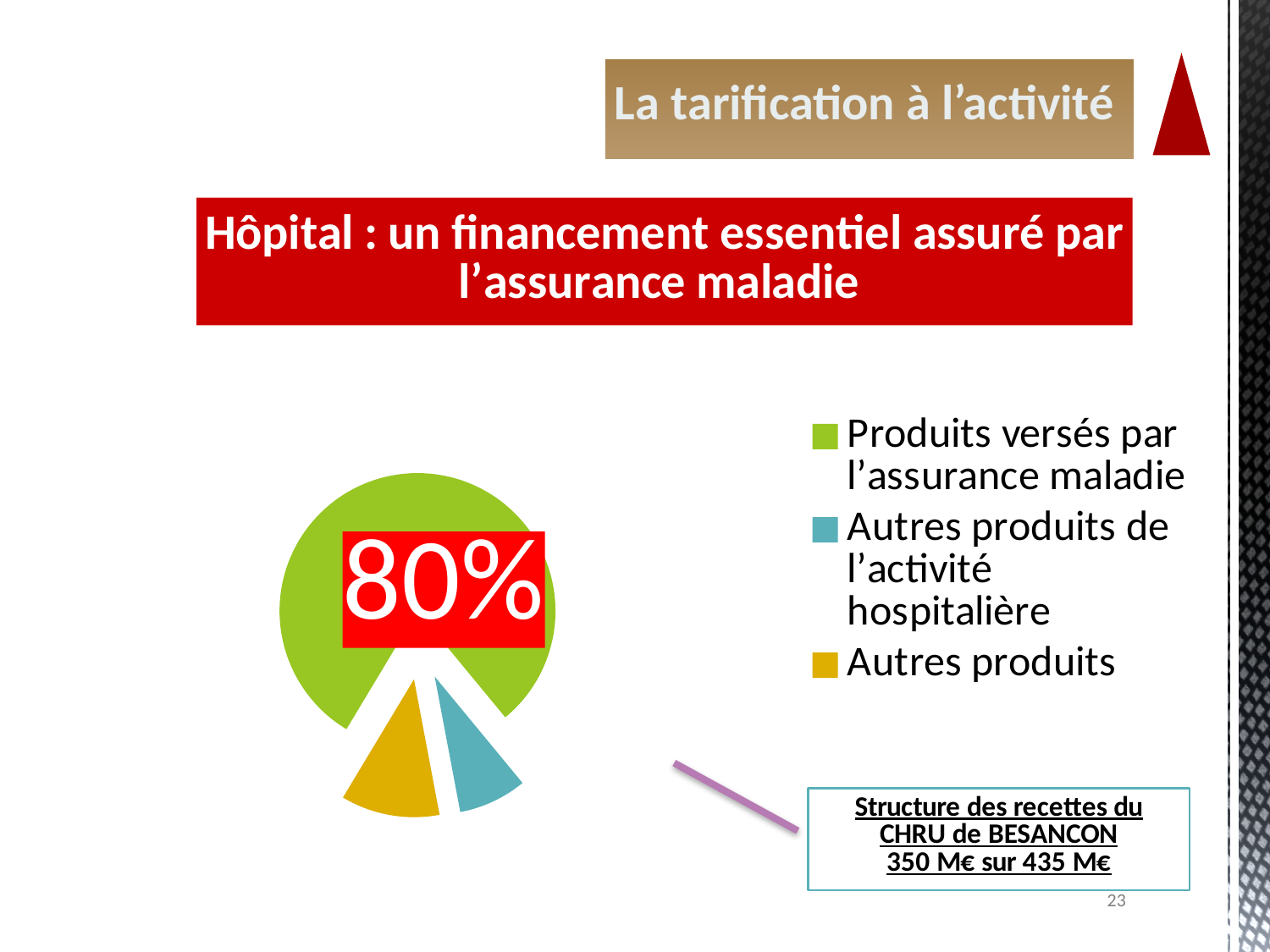
Which slice is larger: 'Produits versés par l'assurance maladie' or 'Autres produits'? Produits versés par l'assurance maladie What colour is the slice for 'Autres produits' in the pie chart? yellow How many slices does the pie chart have? 3 Which slice is larger: 'Autres produits' or 'Autres produits de l'activité hospitalière'? Autres produits Which category has the largest slice in the pie chart? Produits versés par l'assurance maladie What share of the pie is labelled for 'Produits versés par l'assurance maladie'? 80% What colour is the slice for 'Produits versés par l'assurance maladie' in the pie chart? green What kind of chart is shown on the slide? pie chart What value is printed on the largest slice of the pie chart? 80% Which category has the smallest slice in the pie chart? Autres produits de l'activité hospitalière How many entries does the legend of the pie chart list? 3